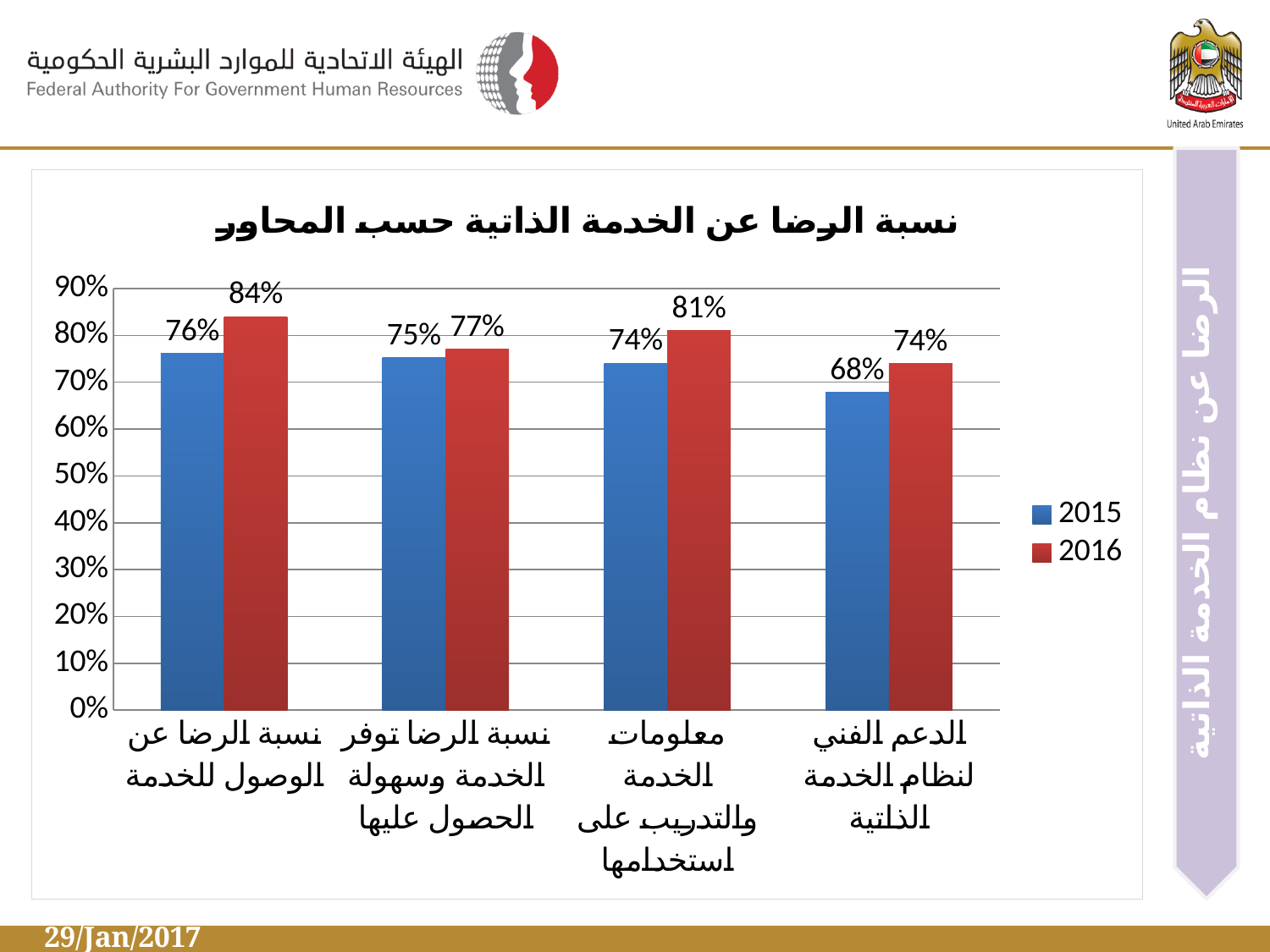
Which category has the lowest 2015 value? الدعم الفني لنظام الخدمة الذاتية What is the 2015 value for "الدعم الفني لنظام الخدمة الذاتية"? 68% What is the 2015 value for "نسبة الرضا توفر الخدمة وسهولة الحصول عليها"? 75% What kind of chart is shown on the slide? Bar chart Which category has the highest 2016 value? نسبة الرضا عن الوصول للخدمة How many series does the legend list? 2 What is the 2016 value for "نسبة الرضا عن الوصول للخدمة"? 84% What is the difference between the 2016 and 2015 values for "معلومات الخدمة والتدريب على استخدامها"? 7% Which is larger: the 2016 value for "الدعم الفني لنظام الخدمة الذاتية" or the 2015 value for "نسبة الرضا عن الوصول للخدمة"? 2015 value for نسبة الرضا عن الوصول للخدمة How many categories are shown on the x axis? 4 What is the difference between the 2016 and 2015 values for "نسبة الرضا عن الوصول للخدمة"? 8% What is the 2016 value for "معلومات الخدمة والتدريب على استخدامها"? 81%